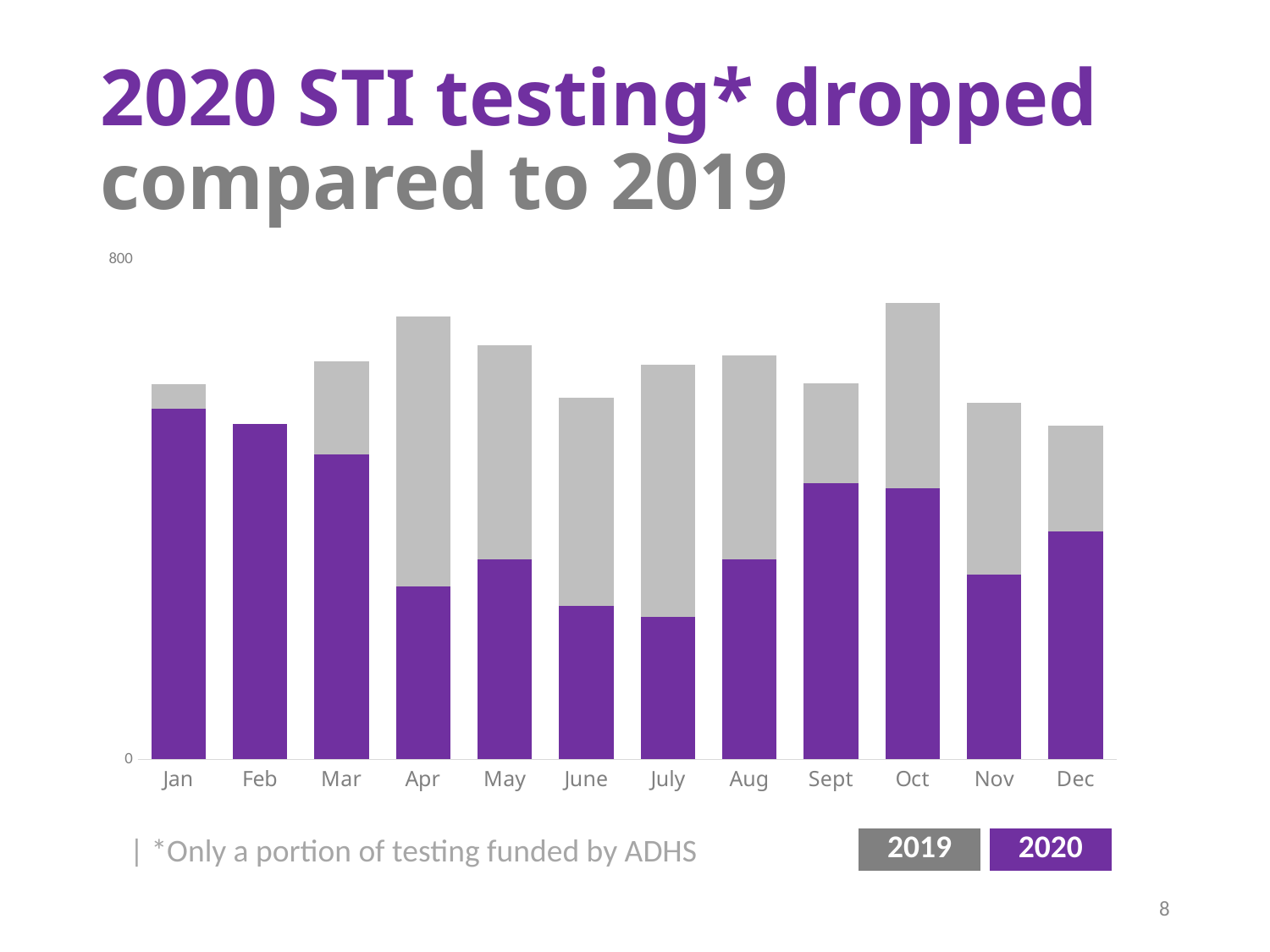
How many series does the chart's legend list? 2 What kind of chart is shown on the slide? Bar chart Which month has the lowest 2020 value? July Which is larger, the 2019 value for Oct or the 2019 value for Dec? Oct In April, which series has the larger value, 2019 or 2020? 2019 Do the 2020 values rise or fall from Feb to July? Fall Is the 2019 value for Oct greater or less than 800? less Which month has the highest 2019 value? Oct Which is larger, the 2020 value for Jan or the 2020 value for July? Jan Which colour represents the 2020 series in the chart? Purple How many months are shown along the x axis of the chart? 12